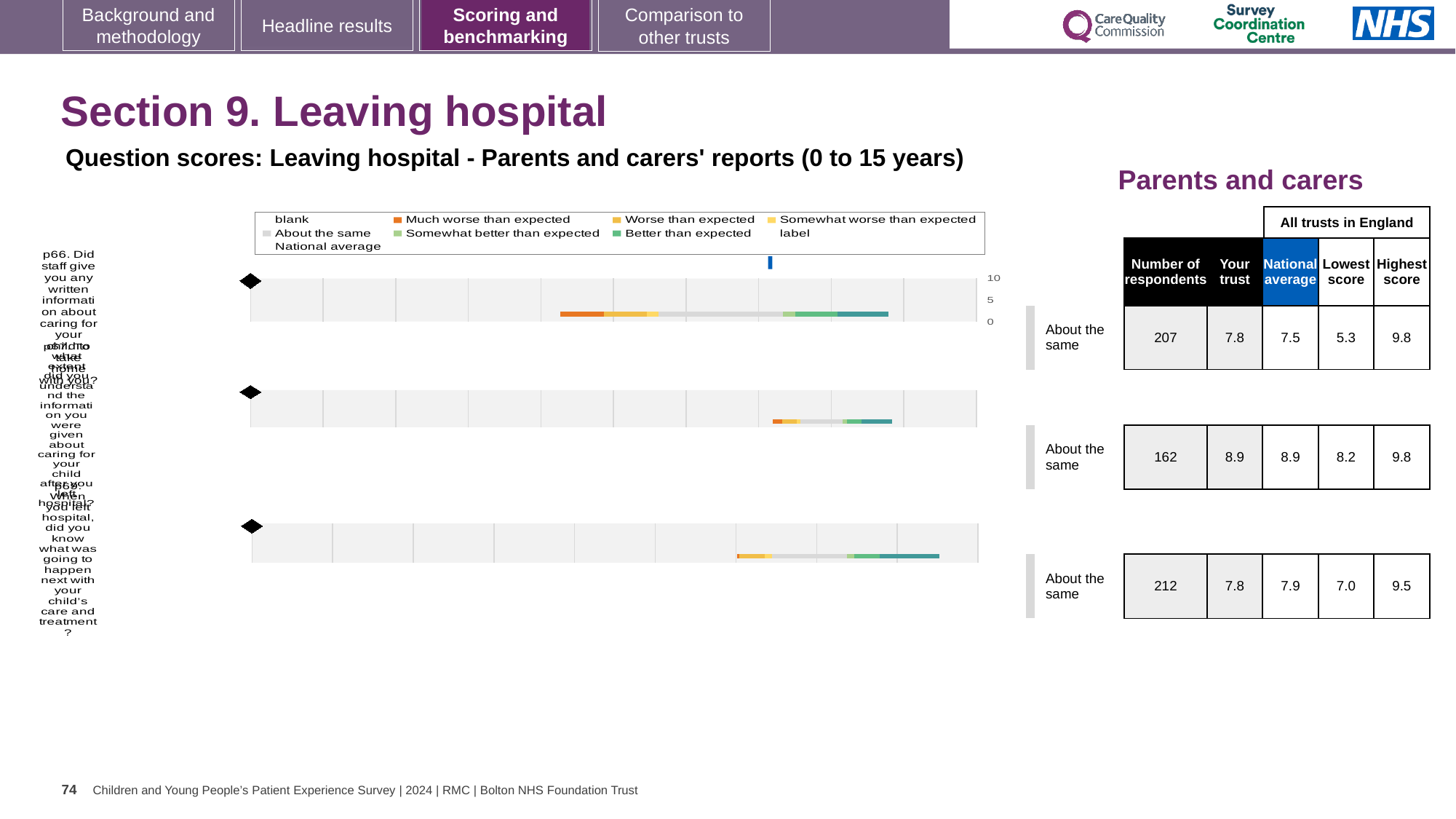
How many benchmark bar charts are shown on the slide? 3 In the table beside the top chart, how many respondents are listed? 207 In the table beside the bottom chart, what is the lowest score among all trusts in England? 7.0 What benchmark category is shown next to each of the three charts? About the same In the table beside the top chart, what is the 'Your trust' score? 7.8 What is the highest tick value shown on the axis to the right of the top chart? 10 In the chart legend, which colour represents 'Much worse than expected'? orange What kind of chart is used to show the question scores on this slide? bar chart Which chart row has the highest 'Your trust' score in the table? the middle chart (8.9) For the top chart's row in the table, what is the difference between the highest score and the lowest score? 4.5 For the bottom chart's row in the table, which is larger: the 'Your trust' score or the national average? National average In the table beside the middle chart, what is the national average score? 8.9